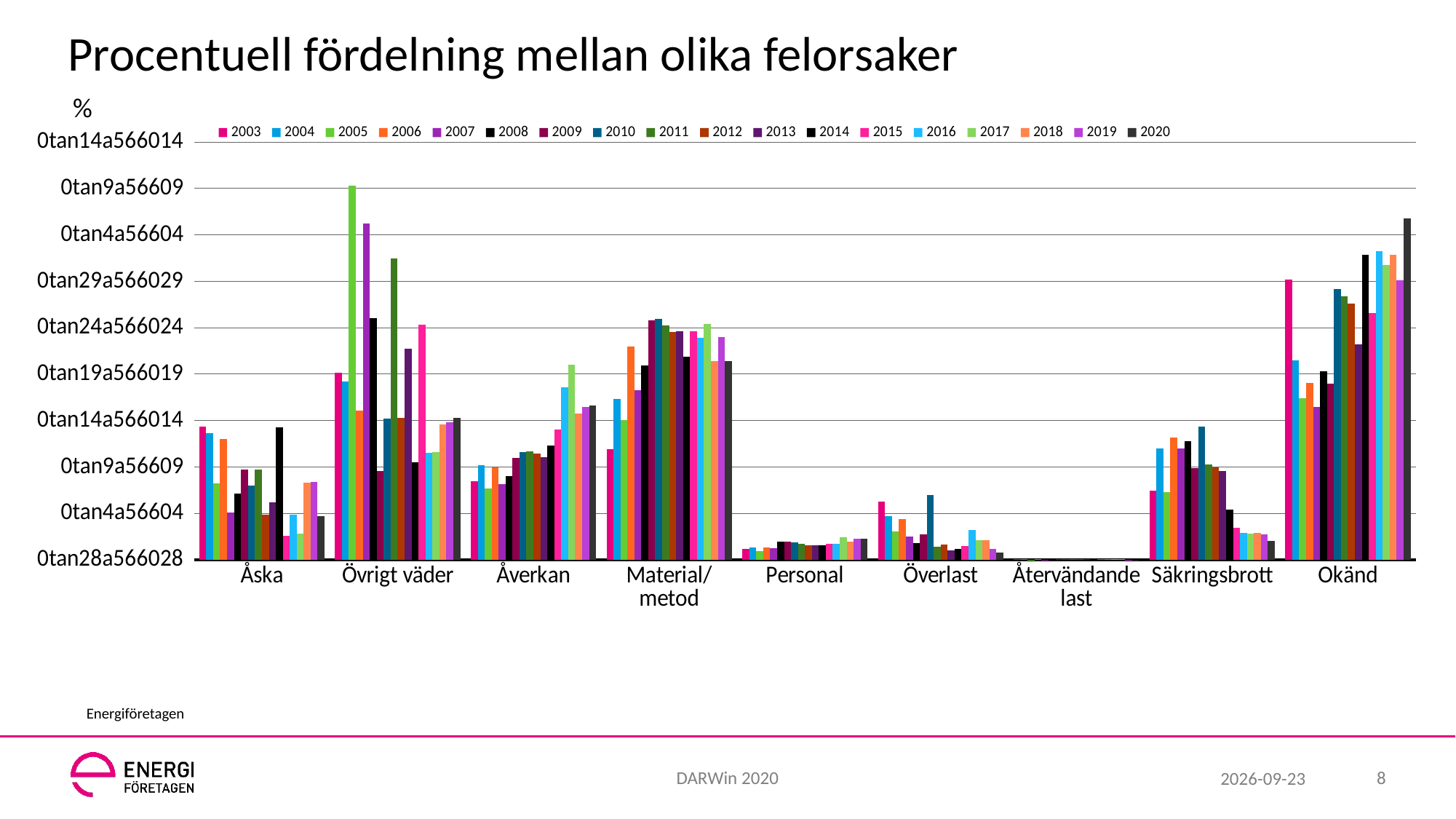
Within the Övrigt väder category, which year has the tallest bar? 2005 Which category contains the tallest bar in the chart? Övrigt väder What kind of chart is shown on the slide? bar chart Which category has the lowest values across all years? Återvändande last For 2010, which is larger: the value for Överlast or the value for Personal? Överlast For 2003, which is larger: the value for Okänd or the value for Åska? Okänd What is the title of the chart? Procentuell fördelning mellan olika felorsaker For 2003, which is larger: the value for Säkringsbrott or the value for Okänd? Okänd How many series does the chart's legend list? 18 Which years are the first and last series listed in the legend? 2003 and 2020 Within the Okänd category, which year has the tallest bar? 2020 How many categories are shown along the x axis of the chart? 9